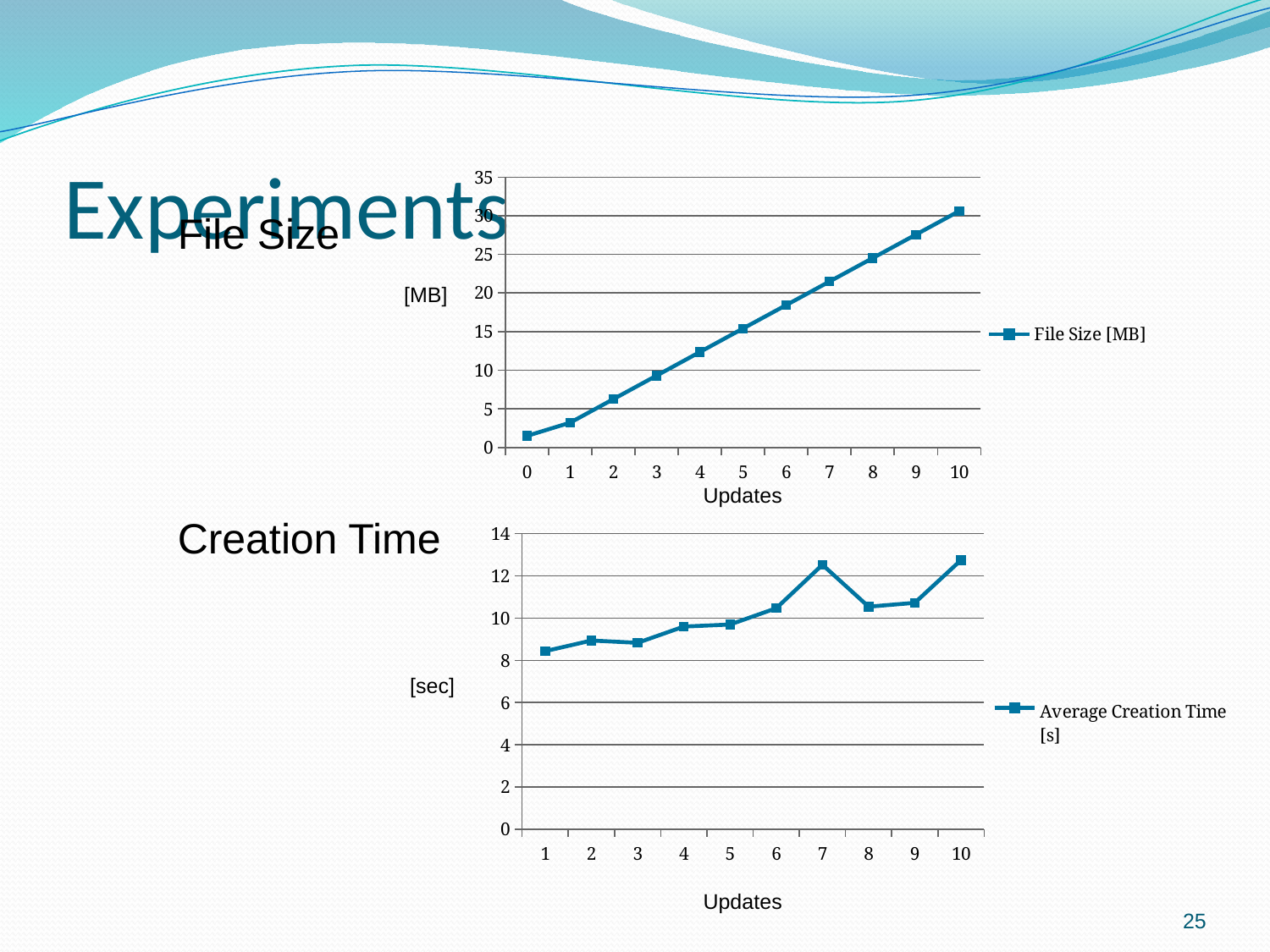
In the Creation Time chart, is the value at 1 update greater or less than 10? less In the File Size chart, how many data points are plotted? 11 What kind of chart is the Creation Time chart? line chart In the File Size chart, is the value at 7 updates greater or less than 20? greater In the Creation Time chart, is the value at 7 updates greater or less than 12? greater In the Creation Time chart, how many data points are plotted? 10 In the Creation Time chart, which is larger, the value at 7 updates or at 8 updates? 7 updates What kind of chart is the File Size chart? line chart In the File Size chart, do the values rise or fall as the number of updates increases? rise What is the legend entry of the Creation Time chart? Average Creation Time [s]